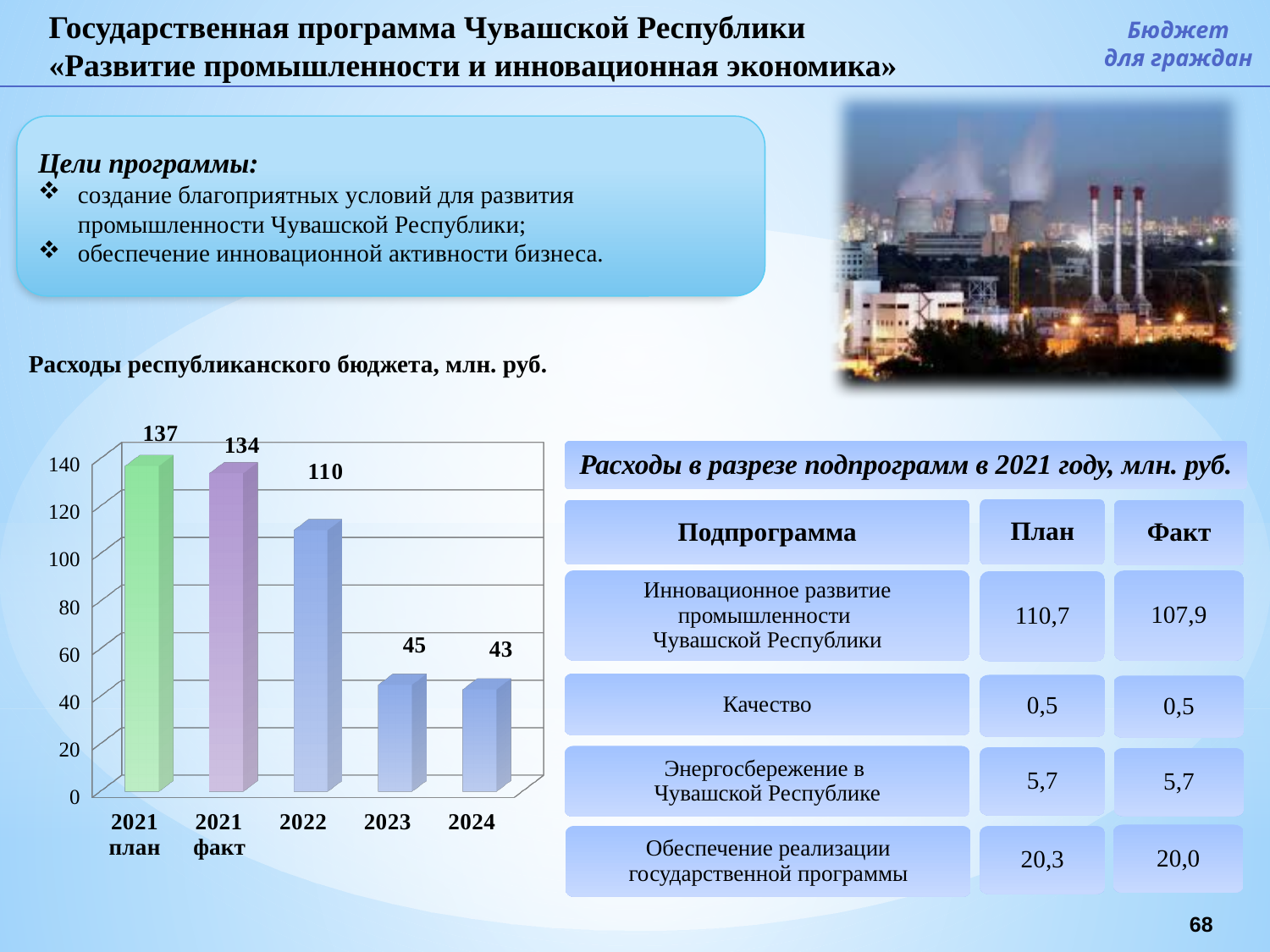
What is the value for 2021 факт in the chart? 134 What is the difference between the values for 2021 план and 2021 факт? 3 What is the value for 2024 in the chart? 43 What kind of chart is shown on the slide? bar chart What is the value for 2021 план in the chart? 137 How many bars are shown in the chart? 5 Which is larger, the value for 2022 or the value for 2023? 2022 Which category has the highest value in the chart? 2021 план Which category has the lowest value in the chart? 2024 What is the value for 2022 in the chart? 110 Do the values rise or fall from 2022 to 2024 along the x axis? fall What is the difference between the values for 2022 and 2023? 65